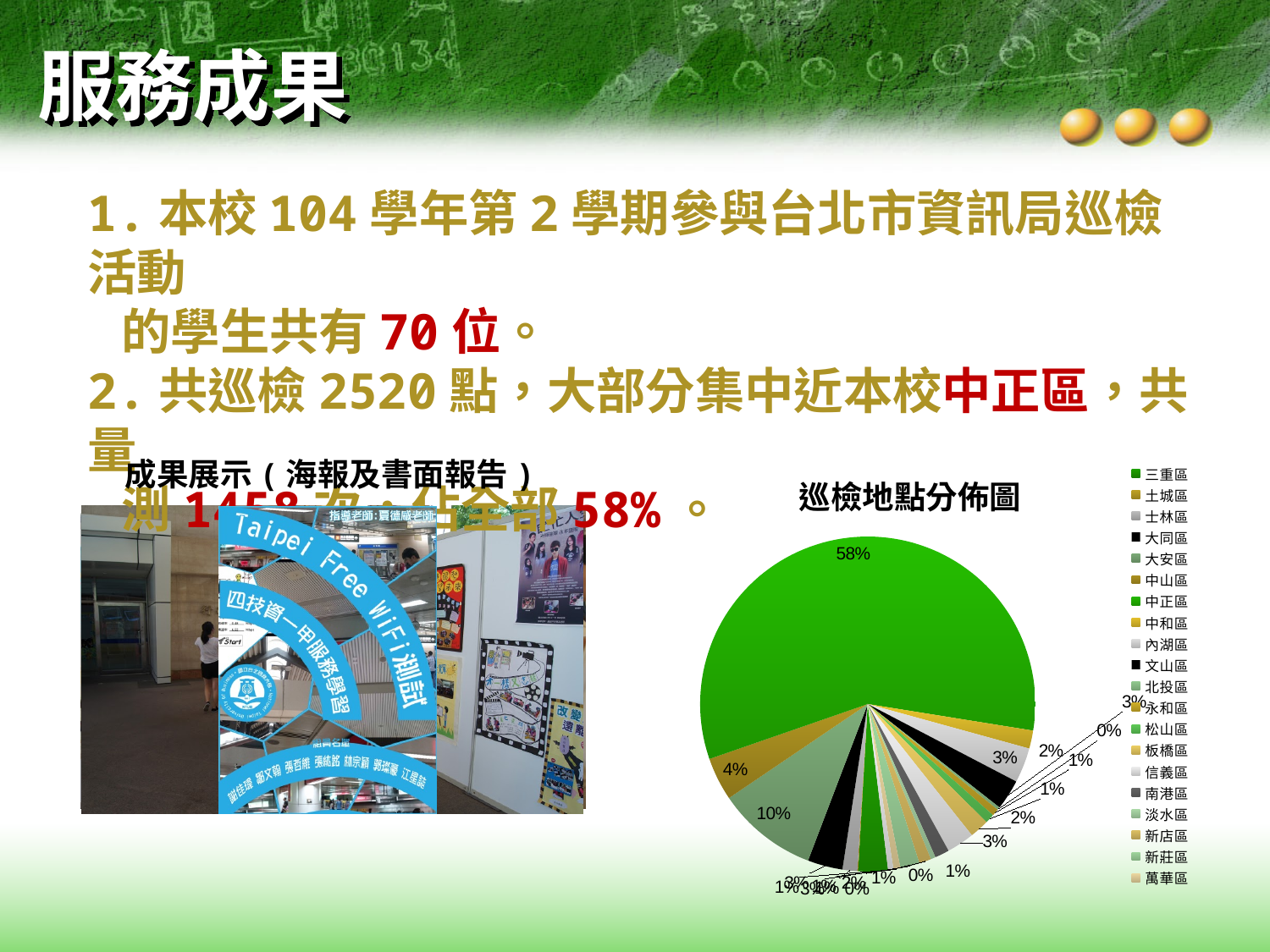
What is the value shown for the largest slice of the pie chart? 58% Which district has the largest slice in the pie chart? 中正區 What is the title of the pie chart? 巡檢地點分佈圖 What colour is the largest slice of the pie chart? green How many districts are listed in the pie chart's legend? 20 What is the second-largest percentage label shown on the pie chart? 10% Is the share for 中正區 greater or less than 50%? greater What kind of chart is shown on the slide? pie chart What percentage of the pie chart does 中正區 account for? 58% Which is larger in the pie chart, the slice for 中正區 or the slice labelled 10%? 中正區